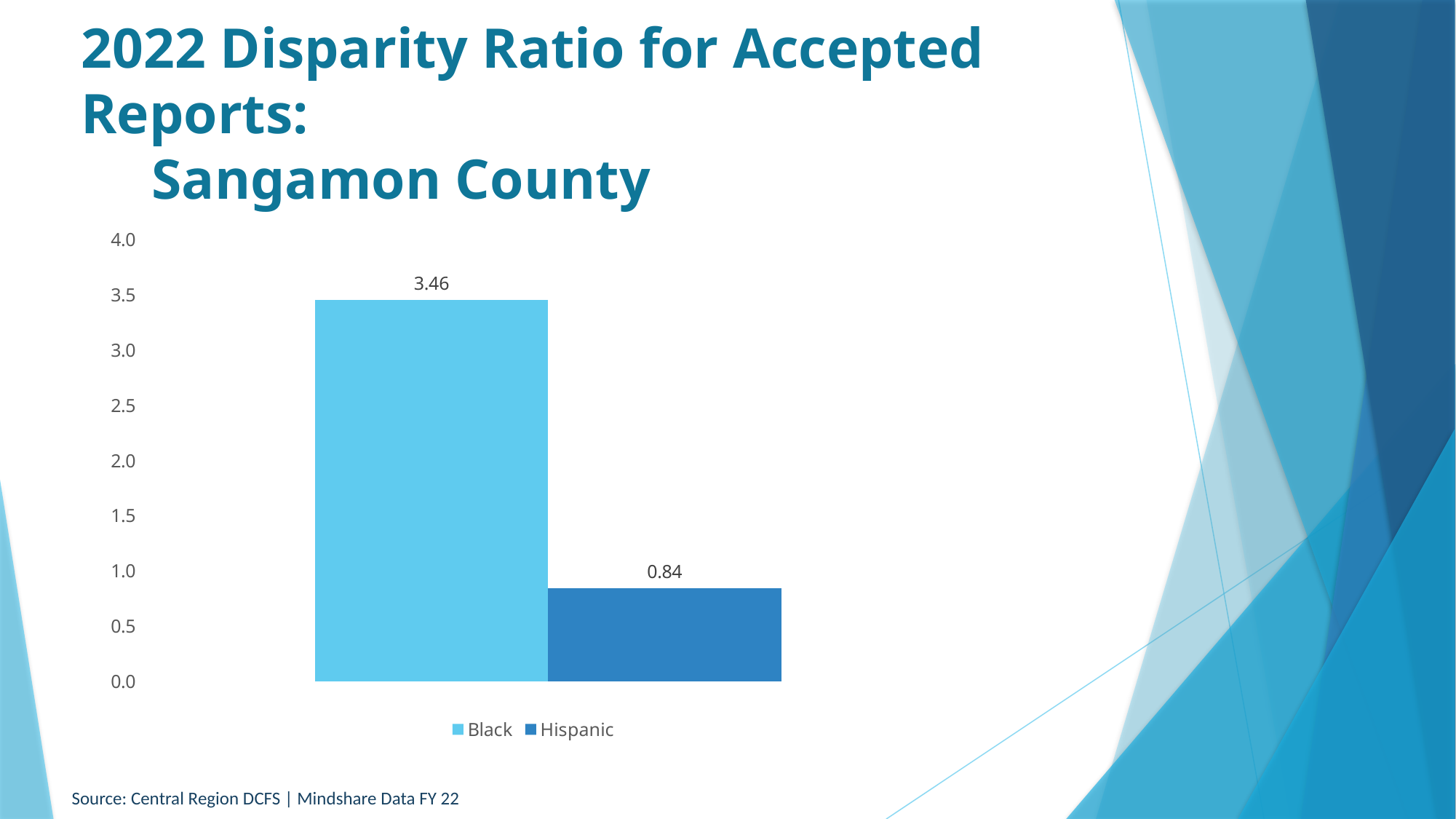
Is the value for Black greater or less than 3.0? greater Is the value for Hispanic greater or less than 1.0? less What is the disparity ratio for Black? 3.46 Which group has the higher disparity ratio? Black Which group has the lower disparity ratio? Hispanic What is the difference between the Black and Hispanic disparity ratios? 2.62 What is the source cited at the bottom of the slide? Central Region DCFS | Mindshare Data FY 22 How many series does the legend list? 2 Is the disparity ratio for Black larger or smaller than the ratio for Hispanic? larger What is the maximum value shown on the vertical axis? 4.0 What is the disparity ratio for Hispanic? 0.84 What kind of chart is shown on the slide? bar chart